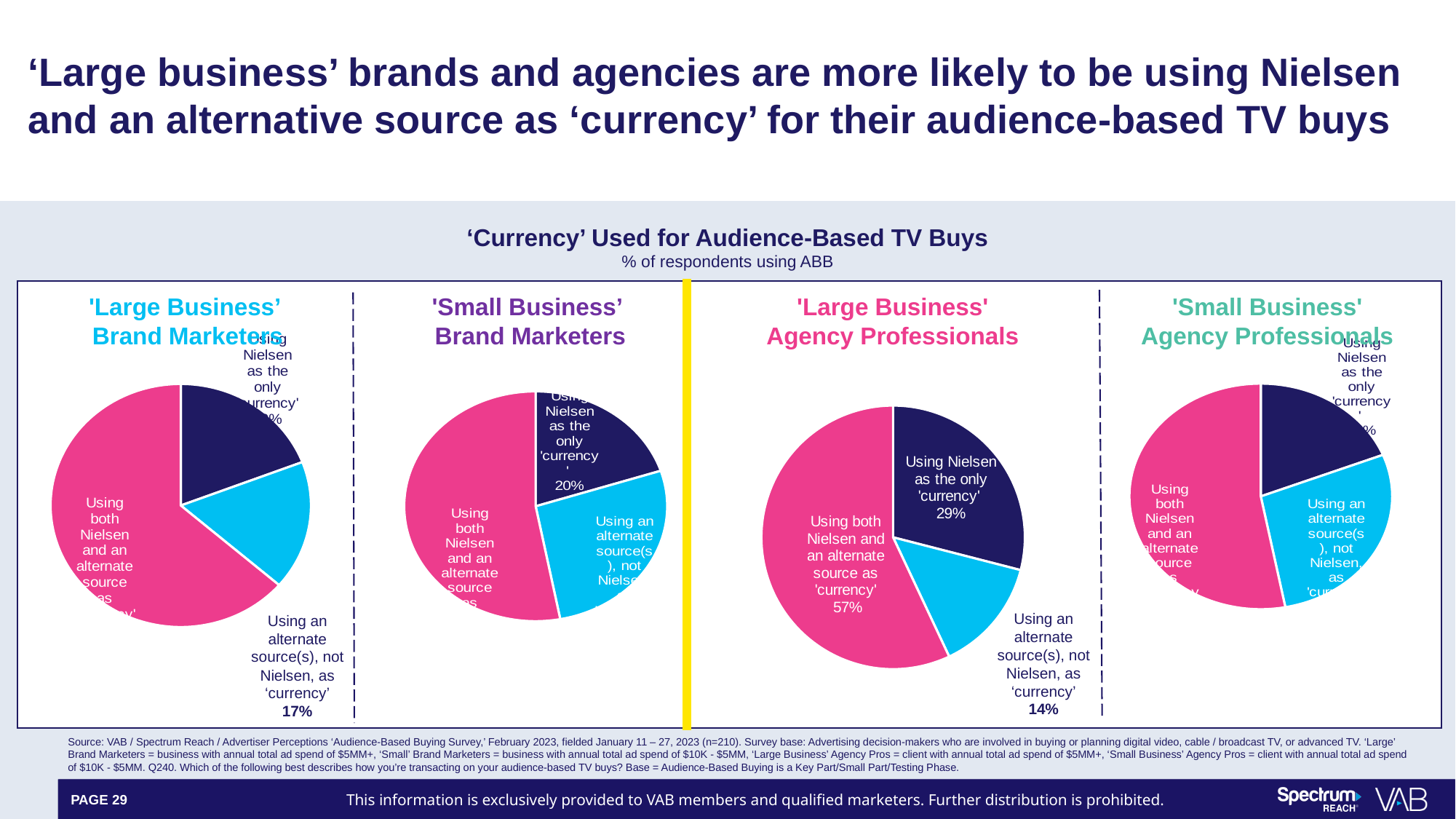
In the 'Large Business' Agency Professionals pie chart, what percentage are using Nielsen as the only 'currency'? 29% In the 'Large Business' Brand Marketers pie chart, what percentage are using an alternate source(s), not Nielsen, as 'currency'? 17% What is the overall title of the charts on the slide? 'Currency' Used for Audience-Based TV Buys In the 'Large Business' Agency Professionals pie chart, which category has the smallest share? Using an alternate source(s), not Nielsen, as 'currency' How many pie charts are shown on the slide? 4 In the 'Small Business' Brand Marketers pie chart, what percentage are using Nielsen as the only 'currency'? 20% In the 'Large Business' Agency Professionals pie chart, how many percentage points larger is the share using both Nielsen and an alternate source than the share using Nielsen as the only 'currency'? 28 percentage points What kind of charts are shown on the slide? Pie charts In the 'Large Business' Agency Professionals pie chart, which is larger: using Nielsen as the only 'currency' or using an alternate source(s), not Nielsen? Using Nielsen as the only 'currency' In the 'Large Business' Agency Professionals pie chart, which category has the largest share? Using both Nielsen and an alternate source as 'currency' In the 'Large Business' Agency Professionals pie chart, what percentage are using both Nielsen and an alternate source as 'currency'? 57% In the 'Large Business' Agency Professionals pie chart, what percentage are using an alternate source(s), not Nielsen, as 'currency'? 14%